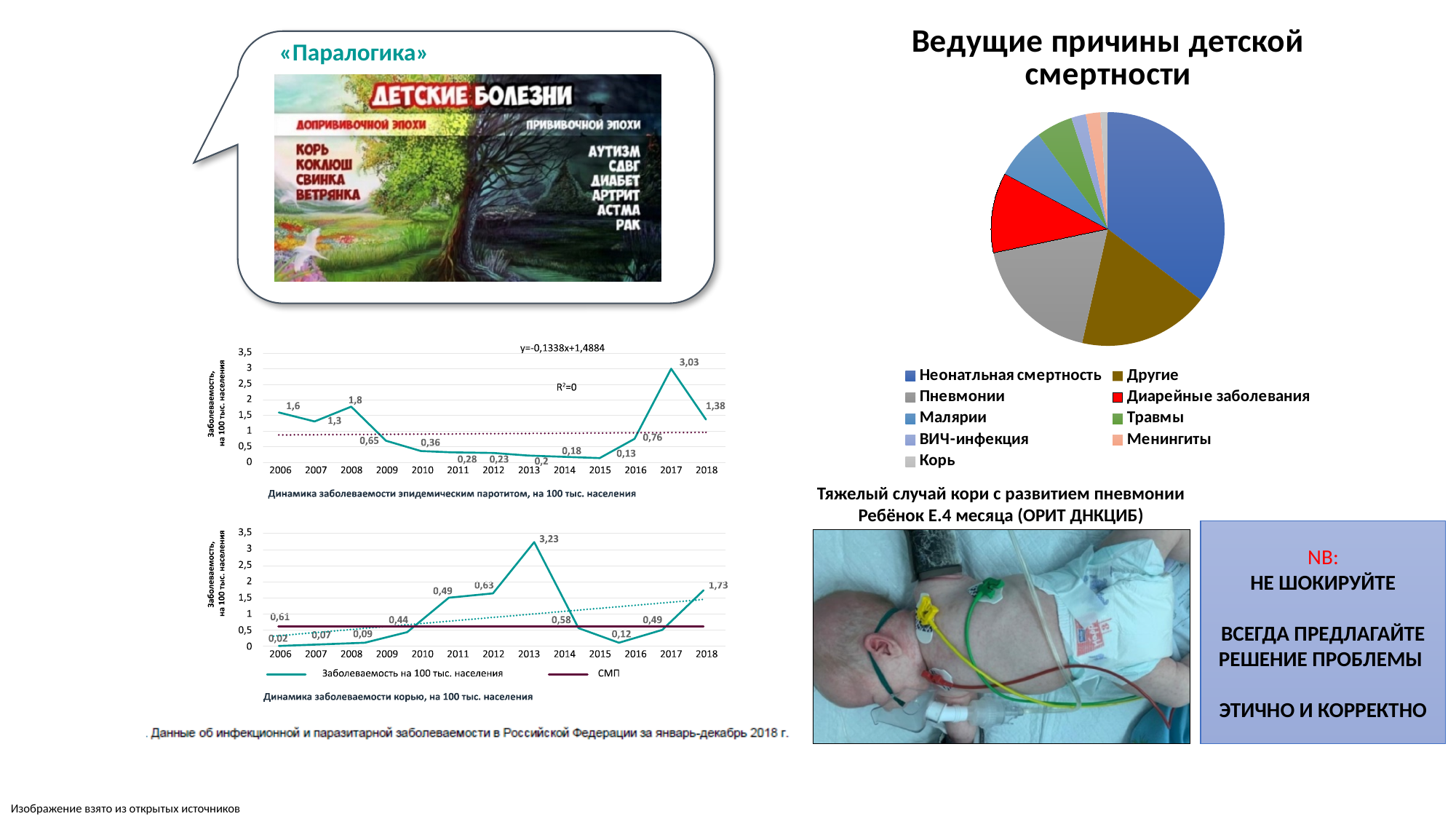
What kind of chart is the chart titled «Ведущие причины детской смертности»? pie chart In the chart «Динамика заболеваемости корью», how many years are shown on the x axis? 13 How many categories does the legend of the pie chart «Ведущие причины детской смертности» list? 9 In the chart «Динамика заболеваемости эпидемическим паротитом», which year has the highest value? 2017 In the chart «Динамика заболеваемости эпидемическим паротитом», which year has the lowest value? 2015 In the chart «Динамика заболеваемости корью», what is the value for 2013? 3,23 In the chart «Динамика заболеваемости эпидемическим паротитом», what is the difference between the values for 2017 and 2018? 1,65 In the pie chart «Ведущие причины детской смертности», what colour is the slice for Диарейные заболевания? red In the chart «Динамика заболеваемости эпидемическим паротитом», which year has the larger value, 2006 or 2008? 2008 In the chart «Динамика заболеваемости эпидемическим паротитом», do the values rise or fall from 2008 to 2015? fall In the chart «Динамика заболеваемости эпидемическим паротитом», what is the value for 2017? 3,03 In the pie chart «Ведущие причины детской смертности», which category has the largest slice? Неонатльная смертность